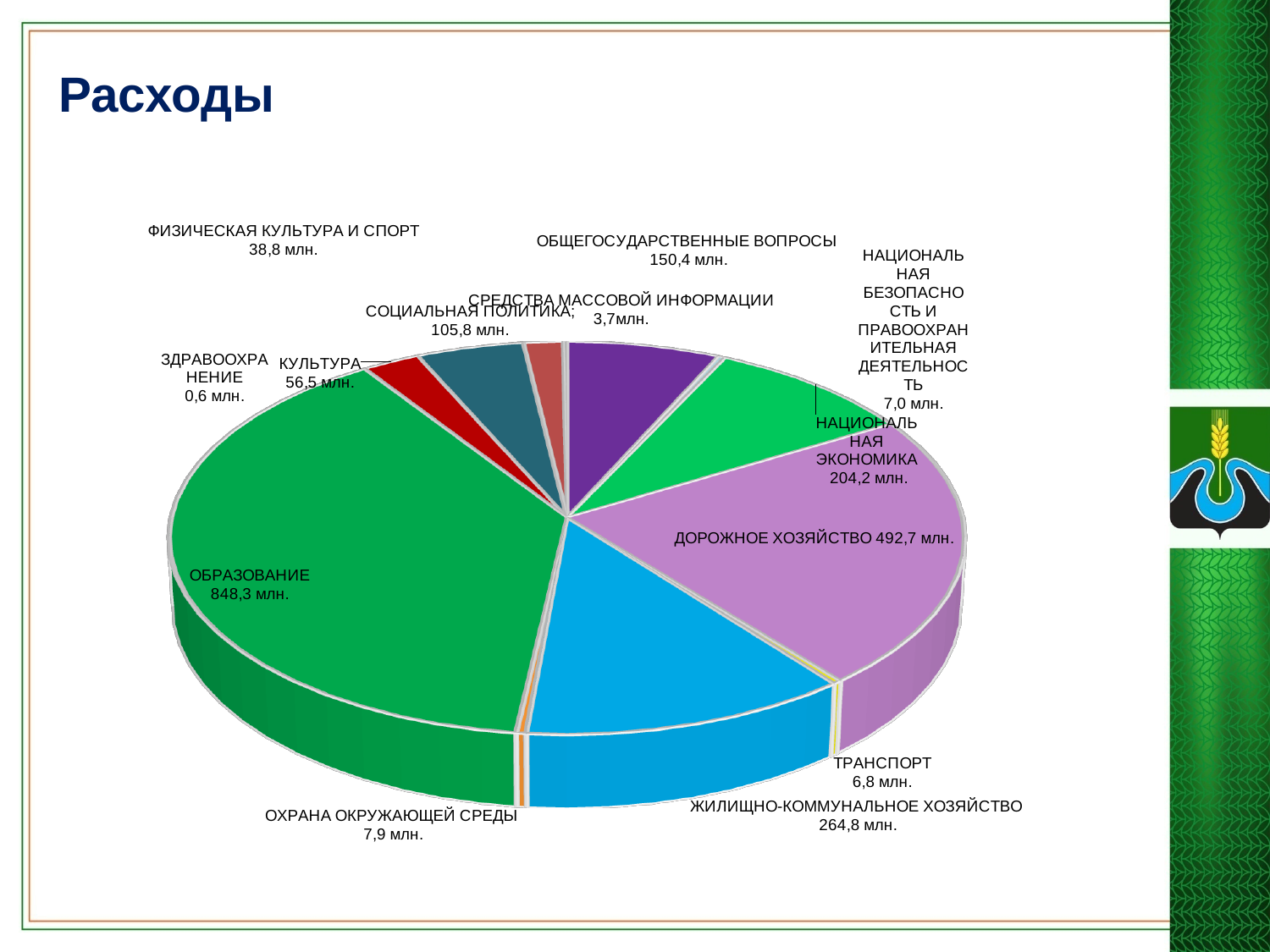
Which category has the largest value? ОБРАЗОВАНИЕ Which category has the smallest value? ЗДРАВООХРАНЕНИЕ What is the value for ЖИЛИЩНО-КОММУНАЛЬНОЕ ХОЗЯЙСТВО? 264,8 млн. What is the value for ДОРОЖНОЕ ХОЗЯЙСТВО? 492,7 млн. What is the value for СОЦИАЛЬНАЯ ПОЛИТИКА? 105,8 млн. What is the value for ЗДРАВООХРАНЕНИЕ? 0,6 млн. What type of chart is shown on the slide? Pie chart What is the value for ОБРАЗОВАНИЕ? 848,3 млн. Which is larger, ОБЩЕГОСУДАРСТВЕННЫЕ ВОПРОСЫ or КУЛЬТУРА? ОБЩЕГОСУДАРСТВЕННЫЕ ВОПРОСЫ What is the difference between ЖИЛИЩНО-КОММУНАЛЬНОЕ ХОЗЯЙСТВО and НАЦИОНАЛЬНАЯ ЭКОНОМИКА? 60,6 млн. How many categories are shown in the pie chart? 13 What is the difference between ОБРАЗОВАНИЕ and ДОРОЖНОЕ ХОЗЯЙСТВО? 355,6 млн.